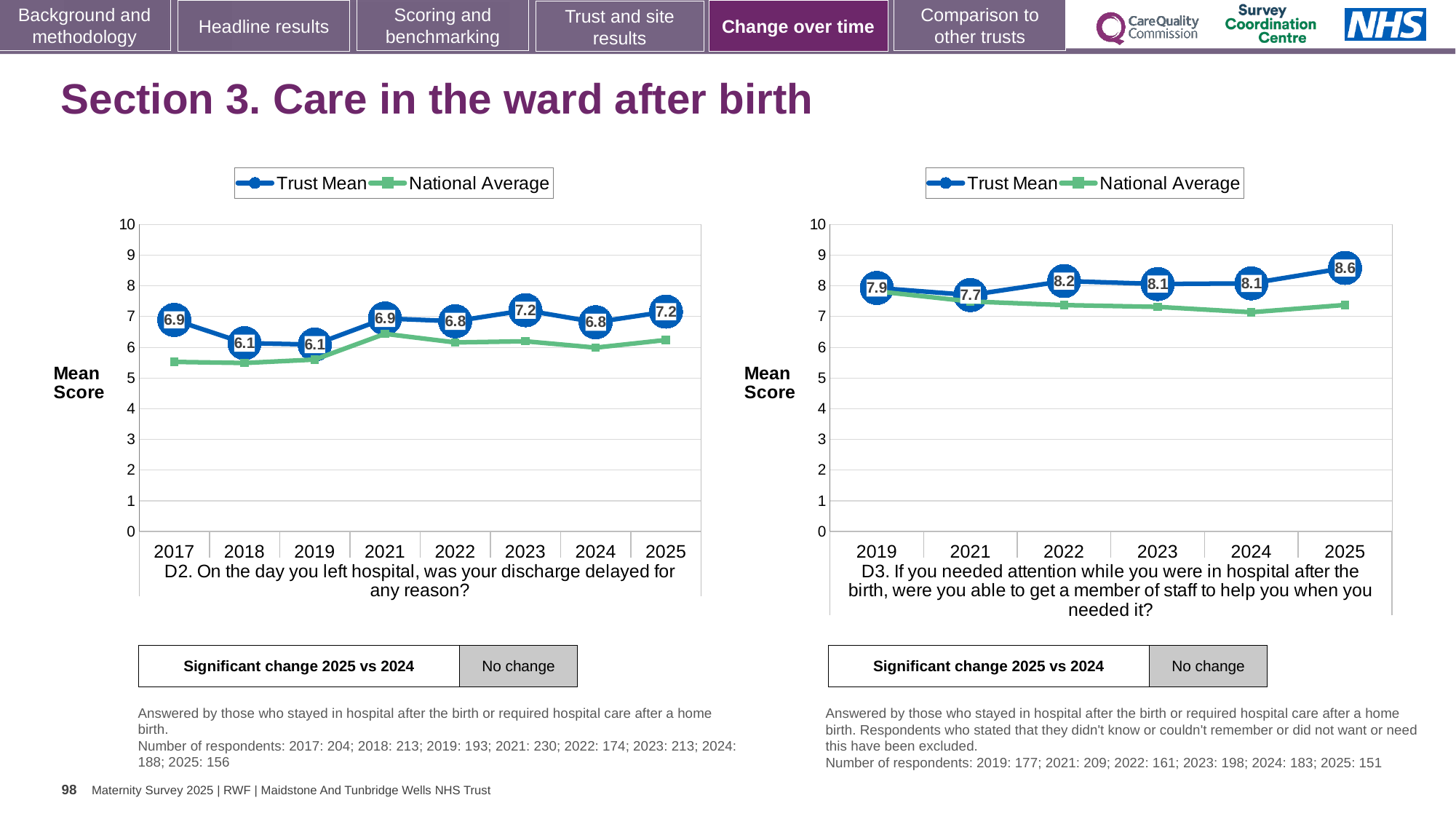
In the left chart (D2), what is the Trust Mean for 2025? 7.2 In the right chart (D3), which year has the highest Trust Mean? 2025 How many years are plotted on the x axis of the left chart (D2)? 8 In the right chart (D3), what is the Trust Mean for 2022? 8.2 In the left chart (D2), is the National Average for 2017 greater or less than 6? less How many series does the legend of the right chart (D3) list? 2 In the right chart (D3), which year has the lowest Trust Mean? 2021 In the left chart (D2), what is the difference between the Trust Mean for 2023 and the Trust Mean for 2018? 1.1 What kind of chart is the left chart (D2)? Line chart In the right chart (D3), is the National Average for 2024 greater or less than 8? less In the left chart (D2), which is larger: the Trust Mean for 2017 or the Trust Mean for 2018? 2017 In the right chart (D3), what is the difference between the Trust Mean for 2025 and the Trust Mean for 2019? 0.7